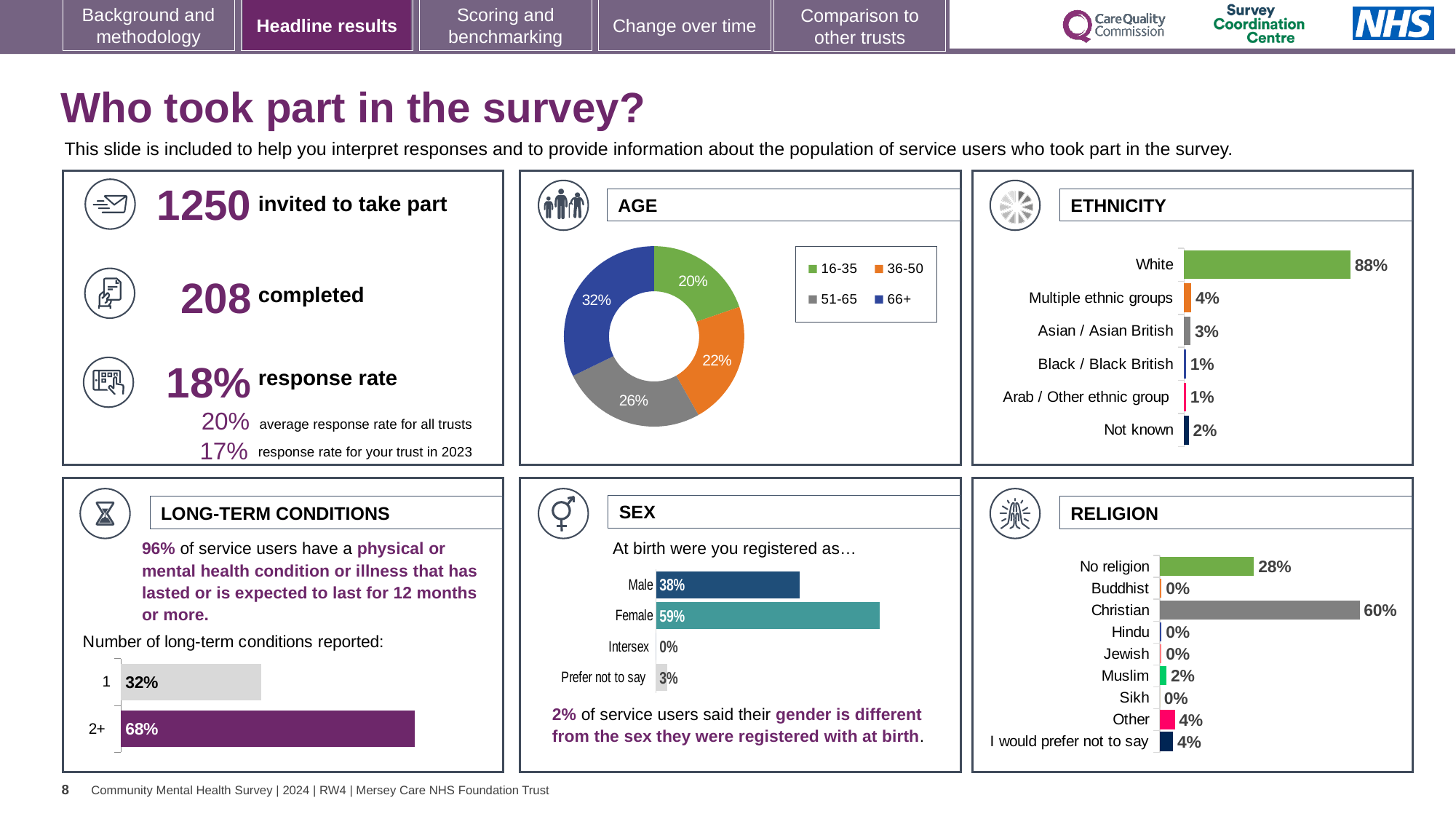
In the RELIGION chart, what is the difference between Christian and No religion? 32% In the ETHNICITY chart, what is the difference between White and Multiple ethnic groups? 84% In the SEX chart, which is larger, Male or Female? Female In the SEX chart, what is the value for Prefer not to say? 3% In the LONG-TERM CONDITIONS chart, what percentage of service users reported 2+ long-term conditions? 68% In the RELIGION chart, which category has the highest value? Christian In the ETHNICITY chart, what is the value for White? 88% How many age groups does the legend of the AGE chart list? 4 What kind of chart is the AGE chart? Donut chart In the AGE chart, what share of respondents are in the 66+ age group? 32% How many categories are shown in the ETHNICITY chart? 6 In the AGE chart, which age group has the smallest share? 16-35